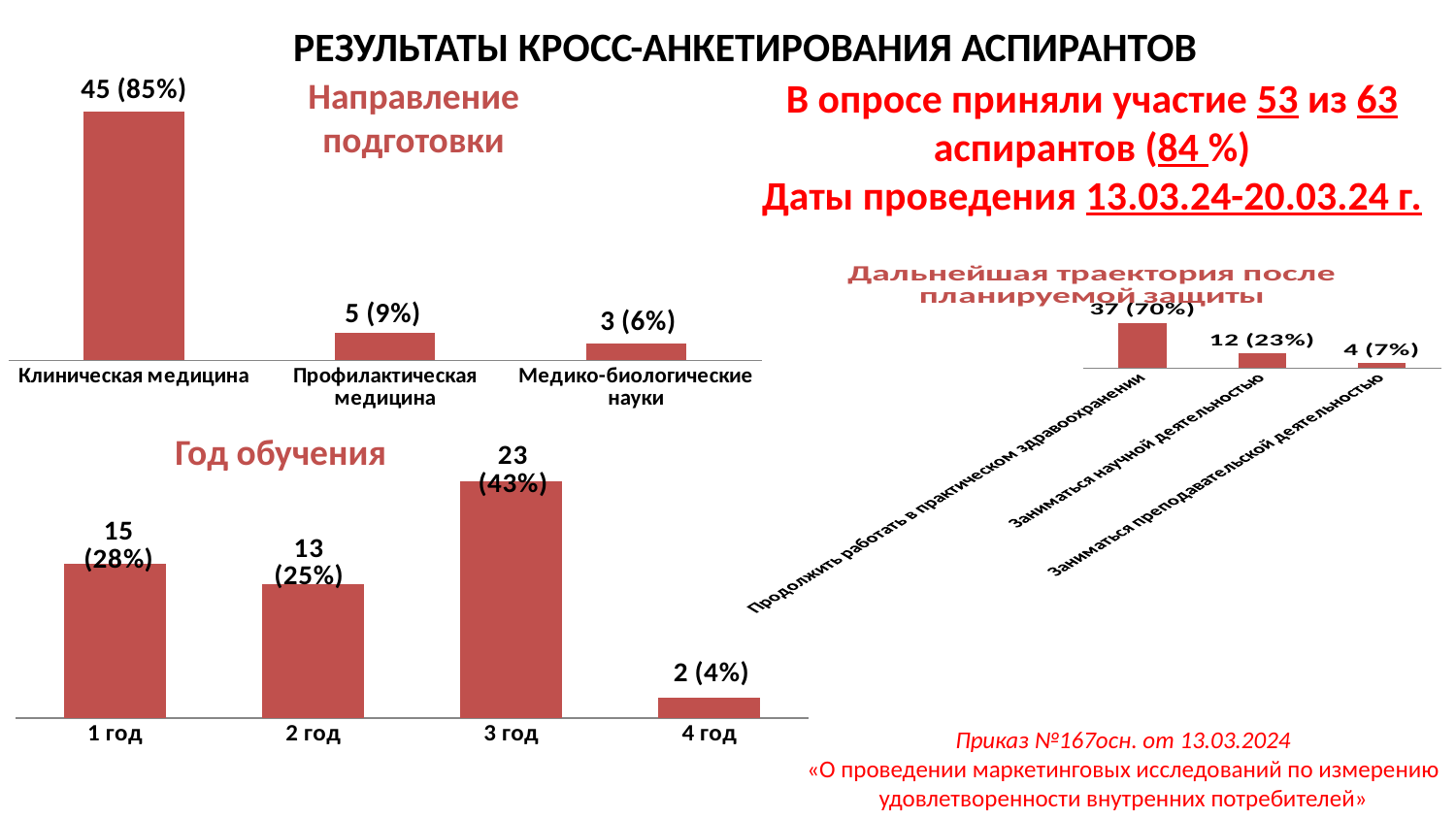
In the 'Направление подготовки' chart, what is the value for Клиническая медицина? 45 (85%) In the 'Направление подготовки' chart, what is the difference in count between Клиническая медицина and Профилактическая медицина? 40 In the 'Направление подготовки' chart, which category has the lowest value? Медико-биологические науки What type of chart is the 'Год обучения' chart? Bar chart In the 'Год обучения' chart, what is the value for 3 год? 23 (43%) In the 'Год обучения' chart, which year has the highest value? 3 год In the 'Дальнейшая траектория после планируемой защиты' chart, which category has the highest value? Продолжить работать в практическом здравоохранении In the 'Год обучения' chart, what is the value for 4 год? 2 (4%) In the 'Направление подготовки' chart, how many categories are shown? 3 In the 'Год обучения' chart, which is larger: 1 год or 2 год? 1 год In the 'Год обучения' chart, how many categories are shown? 4 In the 'Дальнейшая траектория после планируемой защиты' chart, what is the value for 'Заниматься научной деятельностью'? 12 (23%)